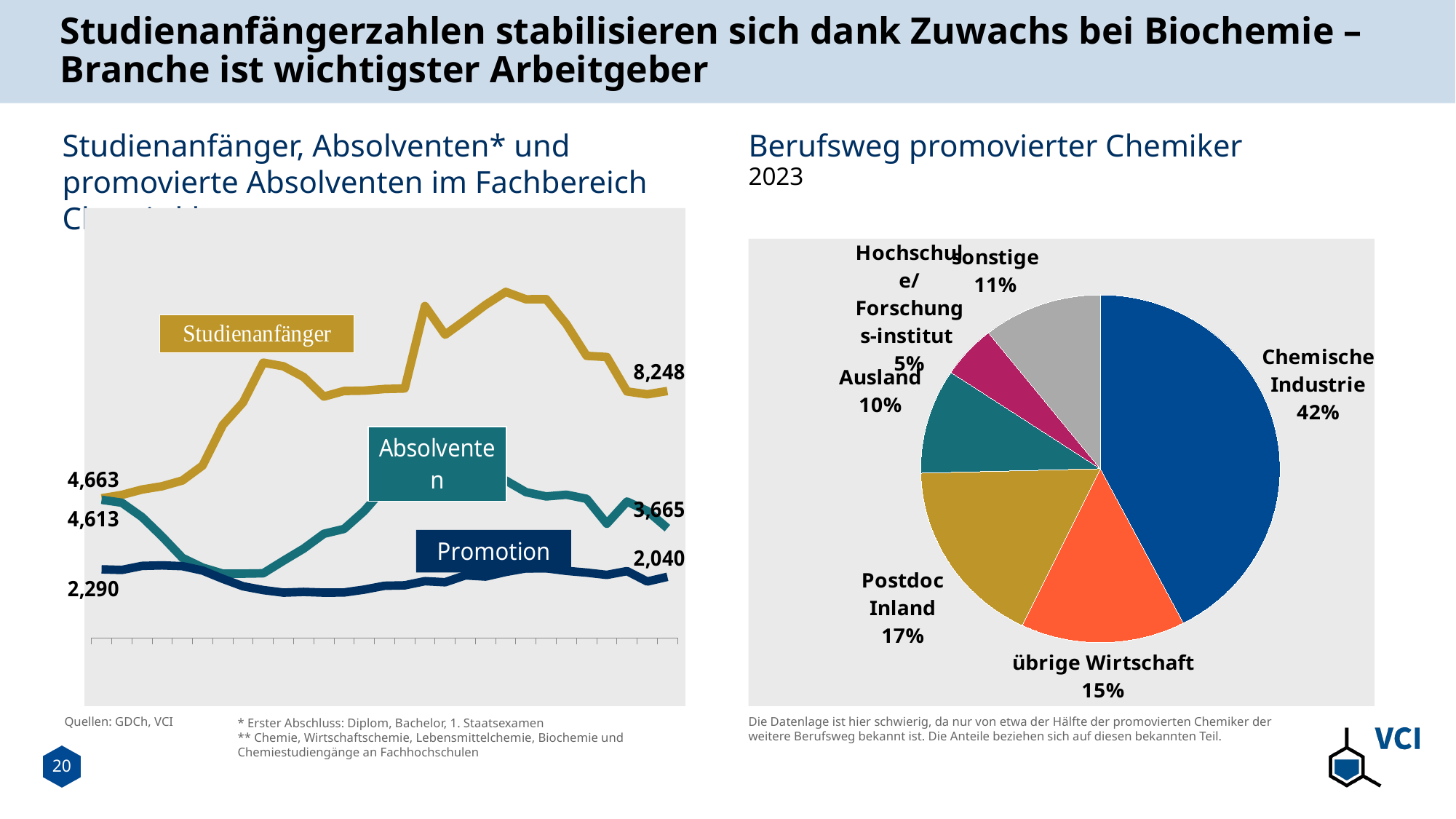
How many slices does the pie chart 'Berufsweg promovierter Chemiker 2023' have? 6 In the line chart on the left, what is the last labelled value for Absolventen? 3,665 In the pie chart 'Berufsweg promovierter Chemiker 2023', how many percentage points larger is Postdoc Inland than übrige Wirtschaft? 2 percentage points In the pie chart 'Berufsweg promovierter Chemiker 2023', which is larger: Ausland or Sonstige? Sonstige How many series are plotted in the line chart on the left of the slide? 3 In the line chart on the left, what is the first labelled value for Promotion? 2,290 What kind of chart is the chart on the right of the slide ('Berufsweg promovierter Chemiker')? Pie chart In the line chart on the left, what is the last labelled value for Studienanfänger? 8,248 In the pie chart 'Berufsweg promovierter Chemiker 2023', which category has the smallest slice? Hochschule/Forschungsinstitut In the pie chart 'Berufsweg promovierter Chemiker 2023', which category has the largest slice? Chemische Industrie In the pie chart 'Berufsweg promovierter Chemiker 2023', what share is labelled for Chemische Industrie? 42% What kind of chart is the chart on the left of the slide ('Studienanfänger, Absolventen und promovierte Absolventen')? Line chart